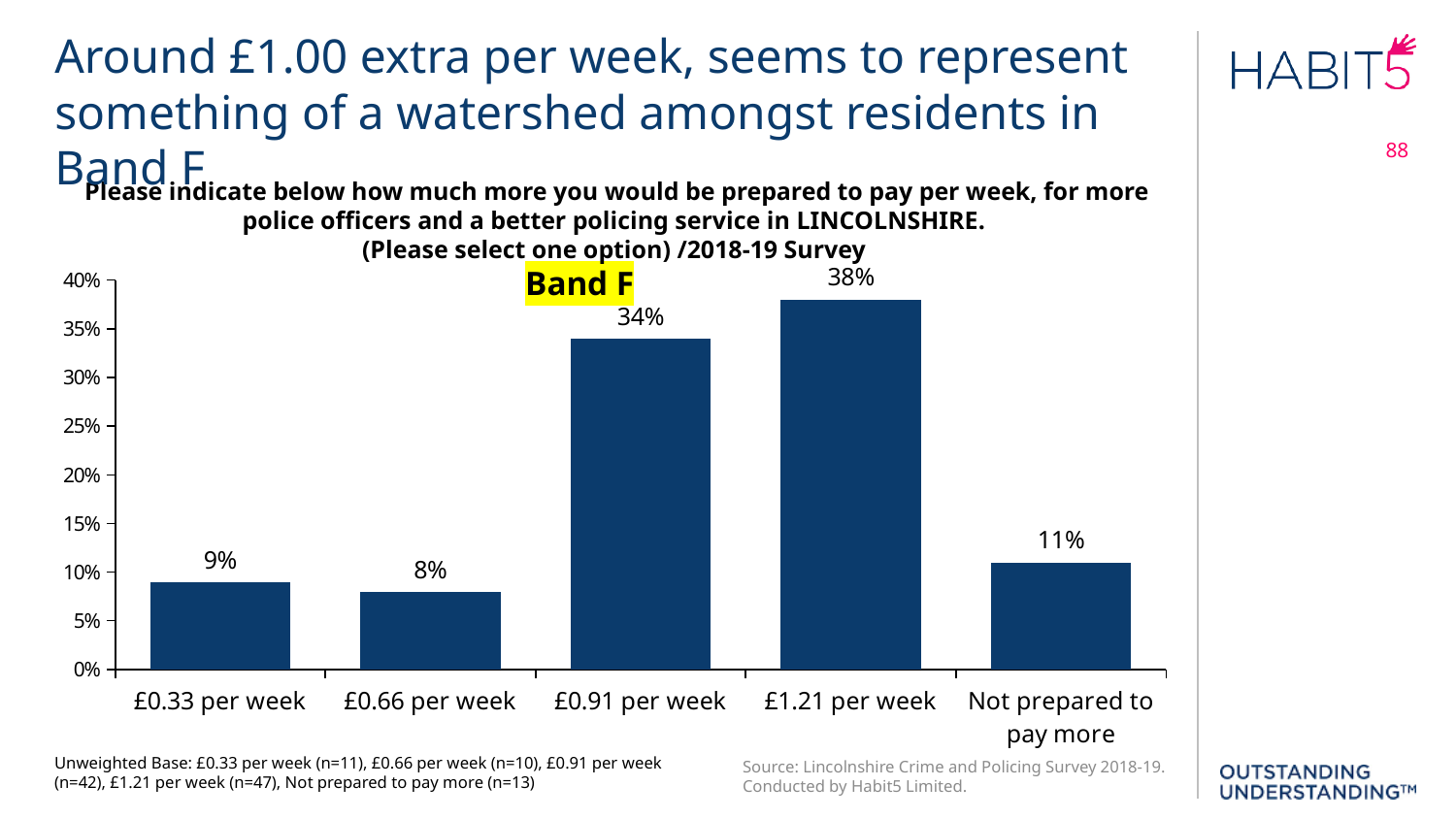
What percentage of Band F respondents would be prepared to pay £1.21 per week? 38% How many response options are shown on the chart? 5 Which has a higher percentage: £0.33 per week or Not prepared to pay more? Not prepared to pay more What percentage of Band F respondents are not prepared to pay more? 11% Is the value for £0.91 per week greater or less than 30%? greater Which council tax band does the chart refer to? Band F What type of chart is shown on the slide? Bar chart What is the difference in percentage points between the £1.21 per week and £0.91 per week options? 4 What percentage of Band F respondents would be prepared to pay £0.91 per week? 34% What percentage of Band F respondents would be prepared to pay £0.33 per week? 9% Which option has the lowest percentage of Band F respondents? £0.66 per week Which option has the highest percentage of Band F respondents? £1.21 per week